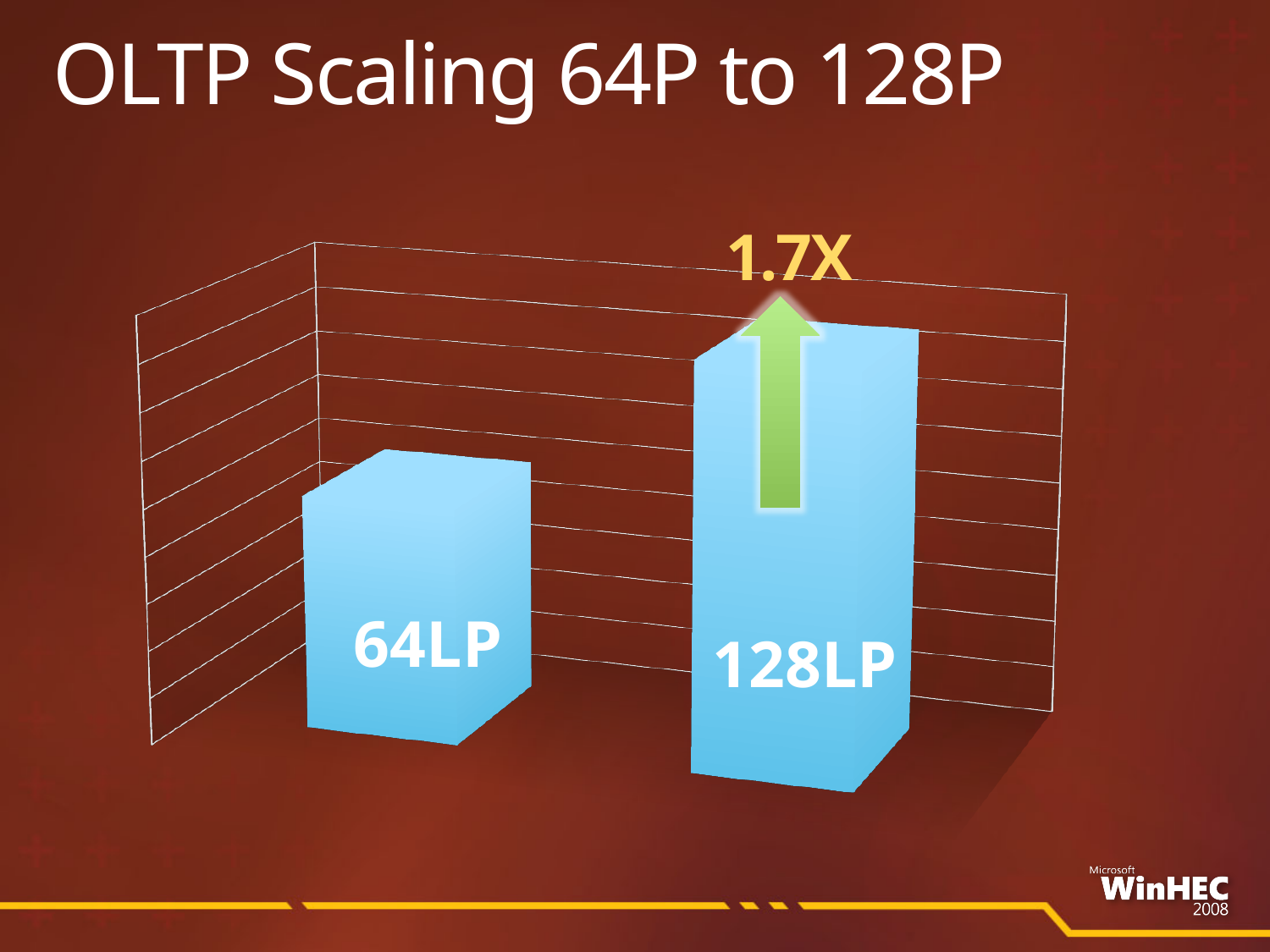
Which bar is the shortest in the chart? 64LP Which bar is taller, 64LP or 128LP? 128LP What scaling factor is annotated above the 128LP bar? 1.7X How many bars are plotted in the chart? 2 What is the title of the slide containing the chart? OLTP Scaling 64P to 128P Do the bar heights rise or fall from 64LP to 128LP? rise Which bar is the tallest in the chart? 128LP What kind of chart is shown on the slide? bar chart